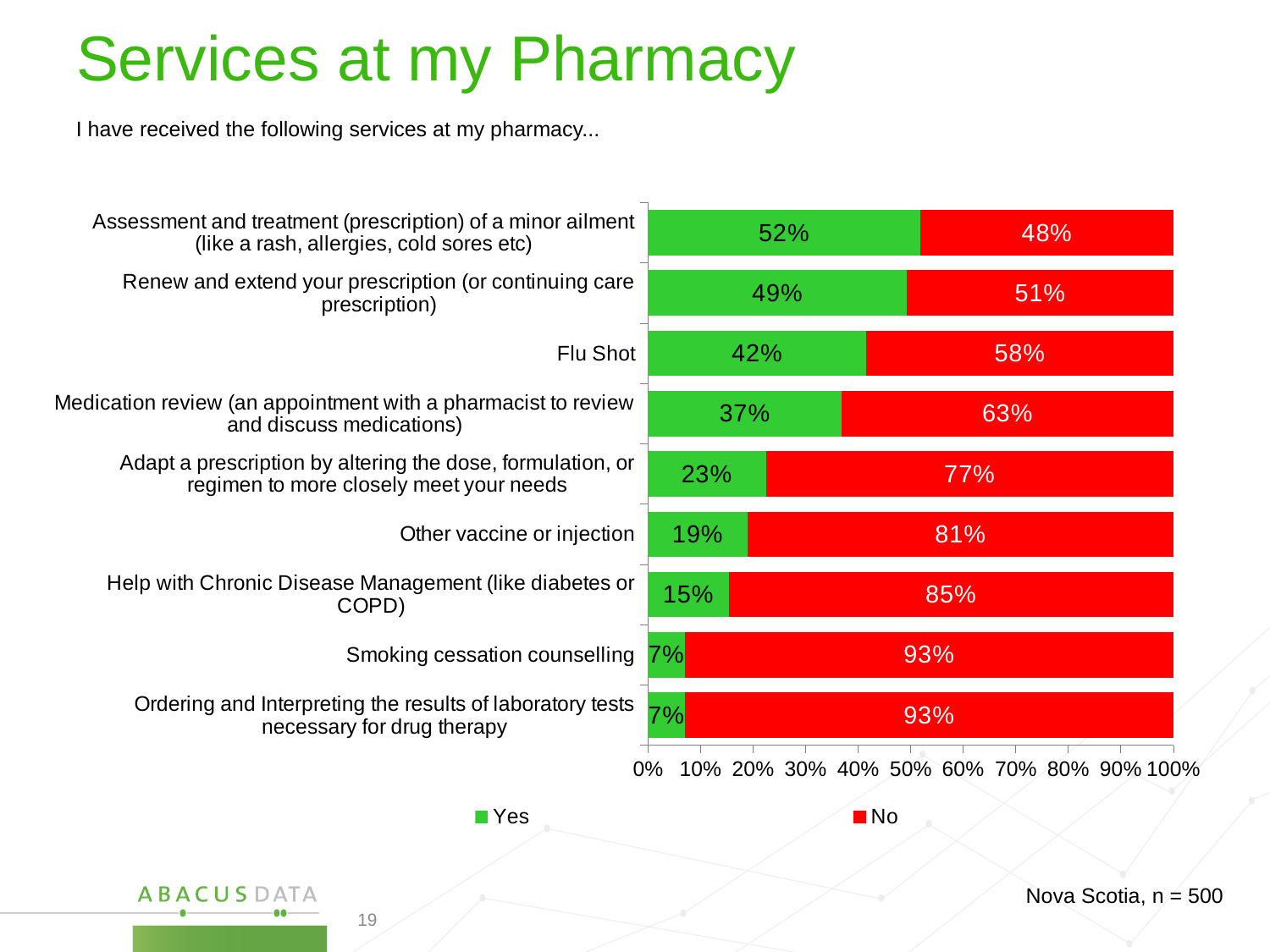
What is the No value for Medication review (an appointment with a pharmacist to review and discuss medications)? 63% What percentage of respondents said Yes to receiving a Flu Shot at their pharmacy? 42% Which service has the highest No percentage? Smoking cessation counselling and Ordering and Interpreting the results of laboratory tests necessary for drug therapy (both 93%) Which is larger: the Yes value for Flu Shot or the Yes value for Other vaccine or injection? Flu Shot What is the total of the Yes and No values for Renew and extend your prescription (or continuing care prescription)? 100% What is the Yes value for Help with Chronic Disease Management (like diabetes or COPD)? 15% What is the difference between the Yes and No values for Adapt a prescription by altering the dose, formulation, or regimen to more closely meet your needs? 54% Which colour represents the No responses in the chart? Red How many series does the legend list? 2 How many services are listed in the chart? 9 Which service has the highest Yes percentage? Assessment and treatment (prescription) of a minor ailment (like a rash, allergies, cold sores etc) What kind of chart is shown on the slide? Stacked bar chart